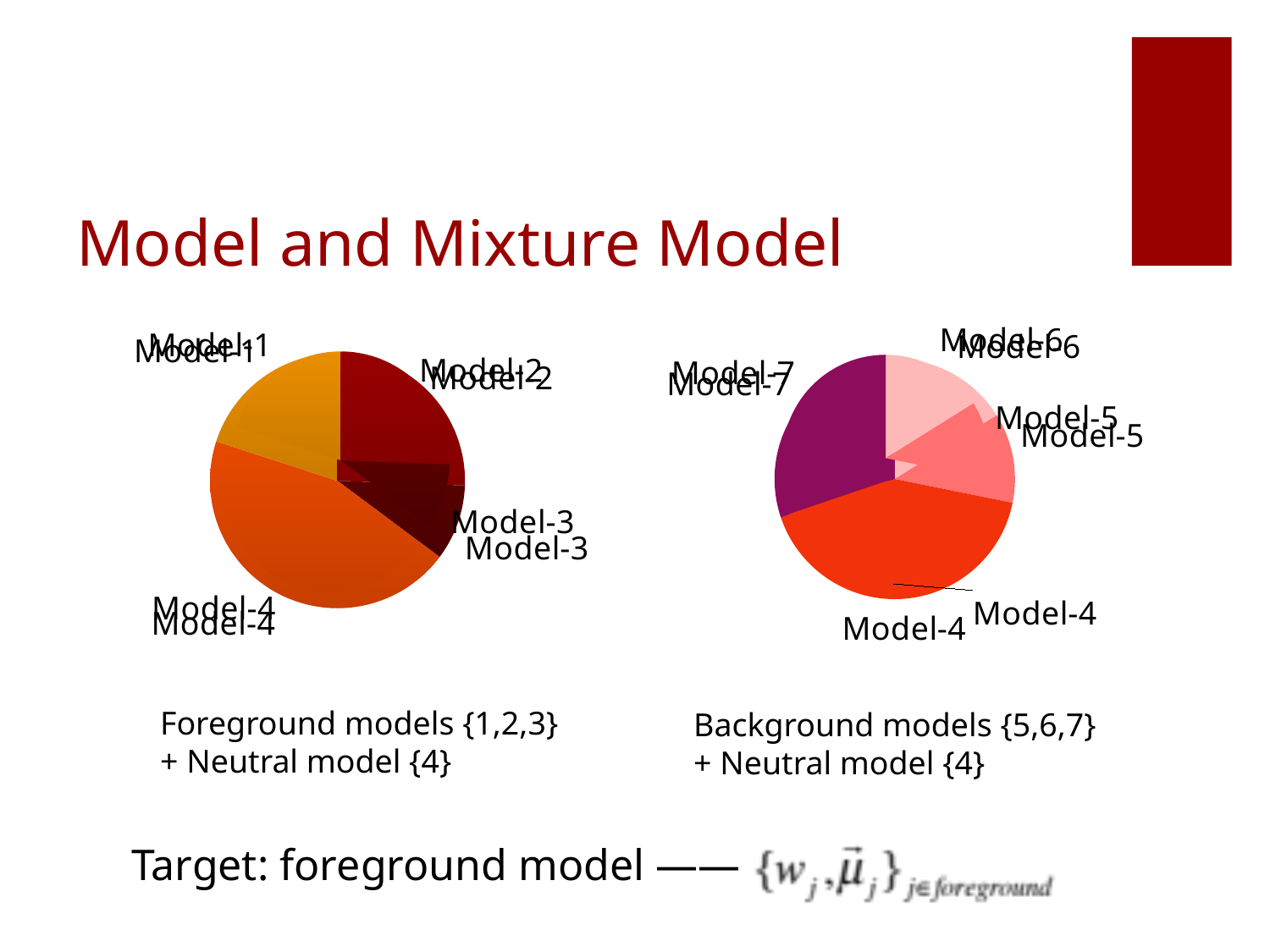
How many slices does the left pie chart have? 4 In the right pie chart, which model has the largest slice? Model-4 Which model appears as a slice in both the left and the right pie chart? Model-4 What is the title of the slide containing the two pie charts? Model and Mixture Model In the left pie chart, which slice is larger, Model-4 or Model-3? Model-4 In the left pie chart, which model has the largest slice? Model-4 How many slices does the right pie chart have? 4 What kind of chart is the right chart on the slide? pie chart In the right pie chart, which model has the smallest slice? Model-5 What kind of chart is the left chart on the slide? pie chart In the left pie chart, which model has the smallest slice? Model-3 In the right pie chart, which slice is larger, Model-7 or Model-6? Model-7